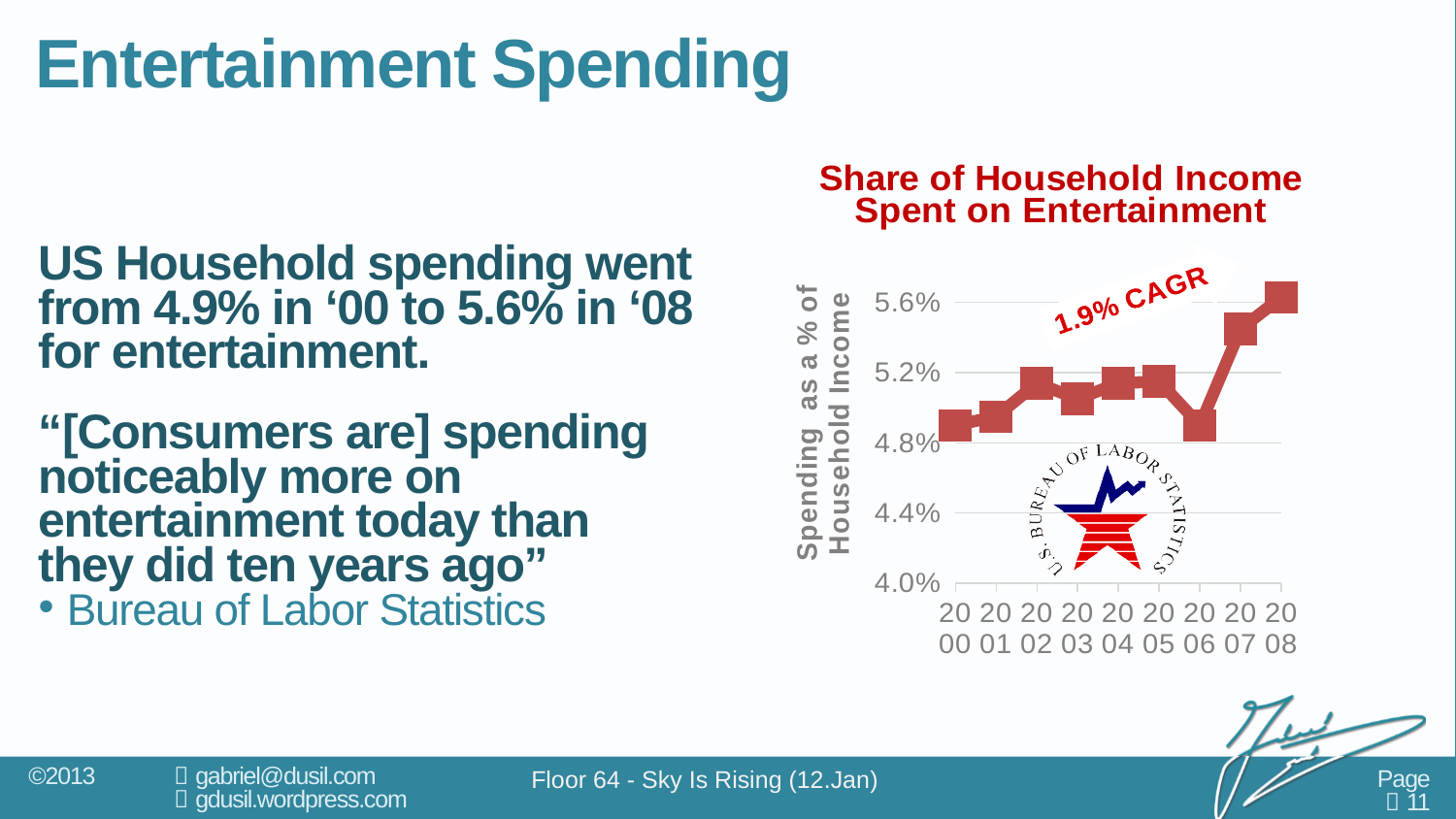
Is the value for 2000 greater or less than 5.2%? less What is the title of the chart? Share of Household Income Spent on Entertainment Which year has the larger value, 2006 or 2007? 2007 Overall, does the share of household income spent on entertainment rise or fall from 2000 to 2008? rise What type of chart is shown on the slide? line chart What CAGR is annotated on the chart? 1.9% CAGR How many years (data points) are plotted on the chart? 9 Is the value for 2006 greater or less than 5.2%? less Is the value for 2007 greater or less than 5.2%? greater Which year has the highest share of household income spent on entertainment? 2008 What is the share of household income spent on entertainment in 2008? 5.6%